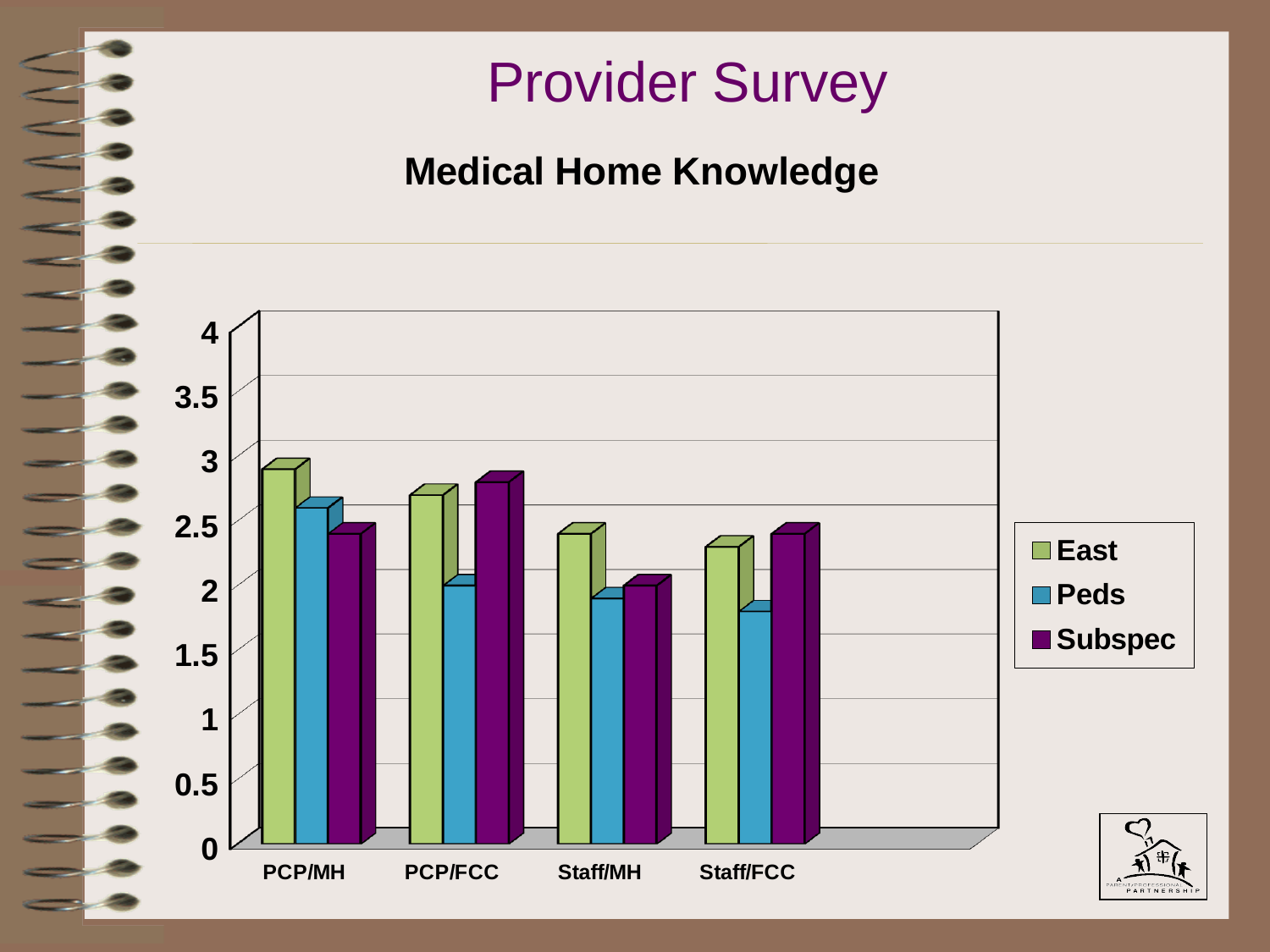
What are the series names listed in the chart's legend? East, Peds, Subspec For PCP/FCC, which is larger, the Peds value or the Subspec value? Subspec How many categories are shown on the x axis of the chart? 4 Do the East values rise or fall moving from PCP/MH to Staff/FCC along the x axis? fall For PCP/MH, which is larger, the East value or the Peds value? East Is the Peds value for Staff/FCC greater or less than 2? less Which category has the highest East value? PCP/MH How many series does the chart's legend list? 3 Is the East value for PCP/MH greater or less than 2.5? greater What kind of chart is shown on the slide? bar chart Is the Subspec value for PCP/FCC greater or less than 2.5? greater What is the title shown above the chart? Medical Home Knowledge